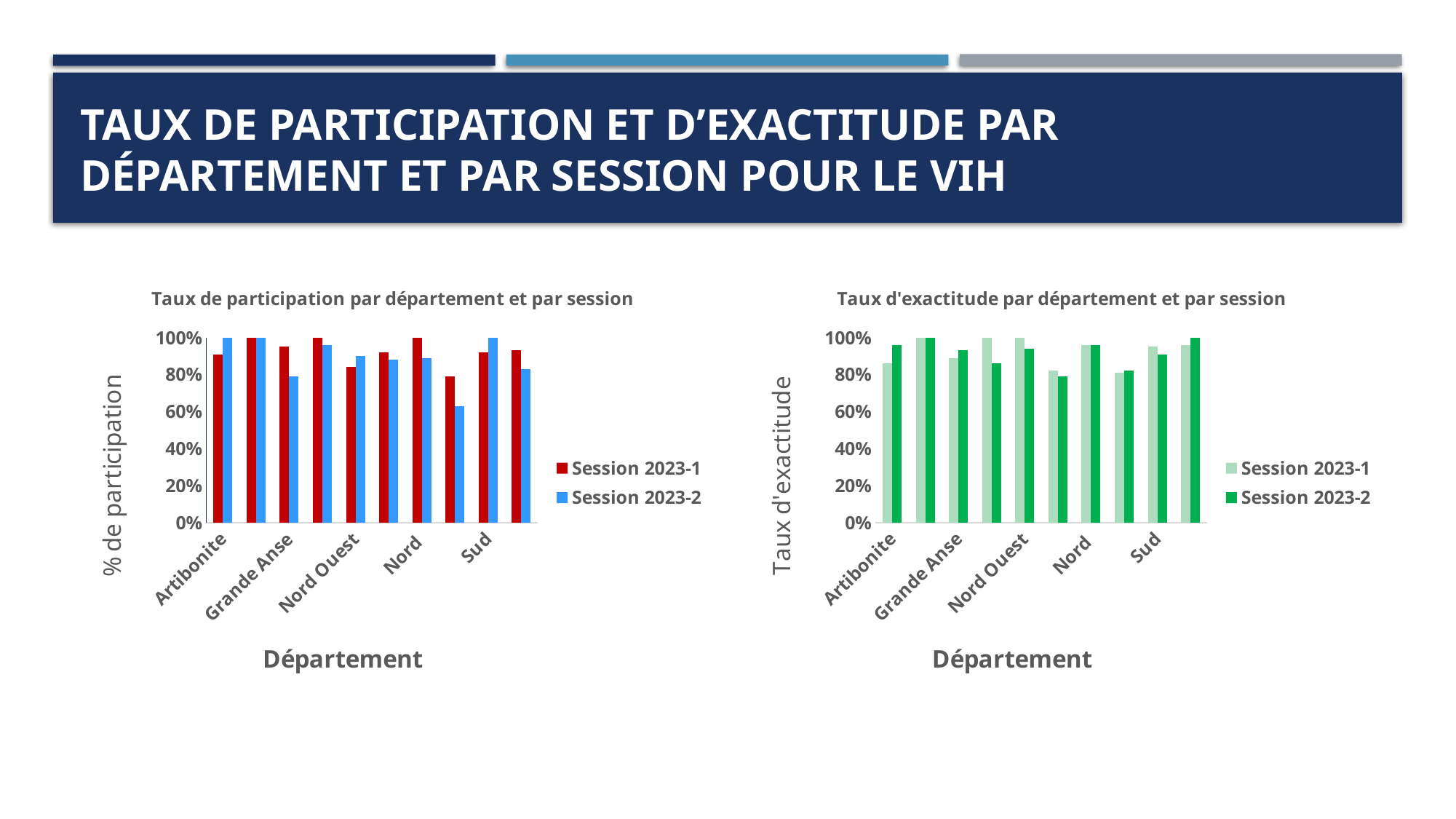
In the chart titled "Taux de participation par département et par session", what is the Session 2023-1 value for Nord? 100% In the left chart (Taux de participation), is the Session 2023-1 value for Artibonite greater or less than 80%? greater In the right chart (Taux d'exactitude), which session has the higher value for Artibonite, Session 2023-1 or Session 2023-2? Session 2023-2 In the left chart (Taux de participation), which session has the higher value for Grande Anse, Session 2023-1 or Session 2023-2? Session 2023-1 In the right chart (Taux d'exactitude), is the Session 2023-2 value for Nord Ouest greater or less than 80%? greater How many series does the legend of the chart titled "Taux d'exactitude par département et par session" list? 2 What is the y-axis title of the right chart (Taux d'exactitude par département et par session)? Taux d'exactitude In the chart titled "Taux d'exactitude par département et par session", what is the Session 2023-1 value for Nord Ouest? 100% In the left chart (Taux de participation), is the Session 2023-2 value for Grande Anse greater or less than 60%? greater In the left chart (Taux de participation), which session has the higher value for Artibonite, Session 2023-1 or Session 2023-2? Session 2023-2 In the chart titled "Taux de participation par département et par session", what is the Session 2023-2 value for Artibonite? 100% What kind of chart is the chart titled "Taux de participation par département et par session"? Bar chart